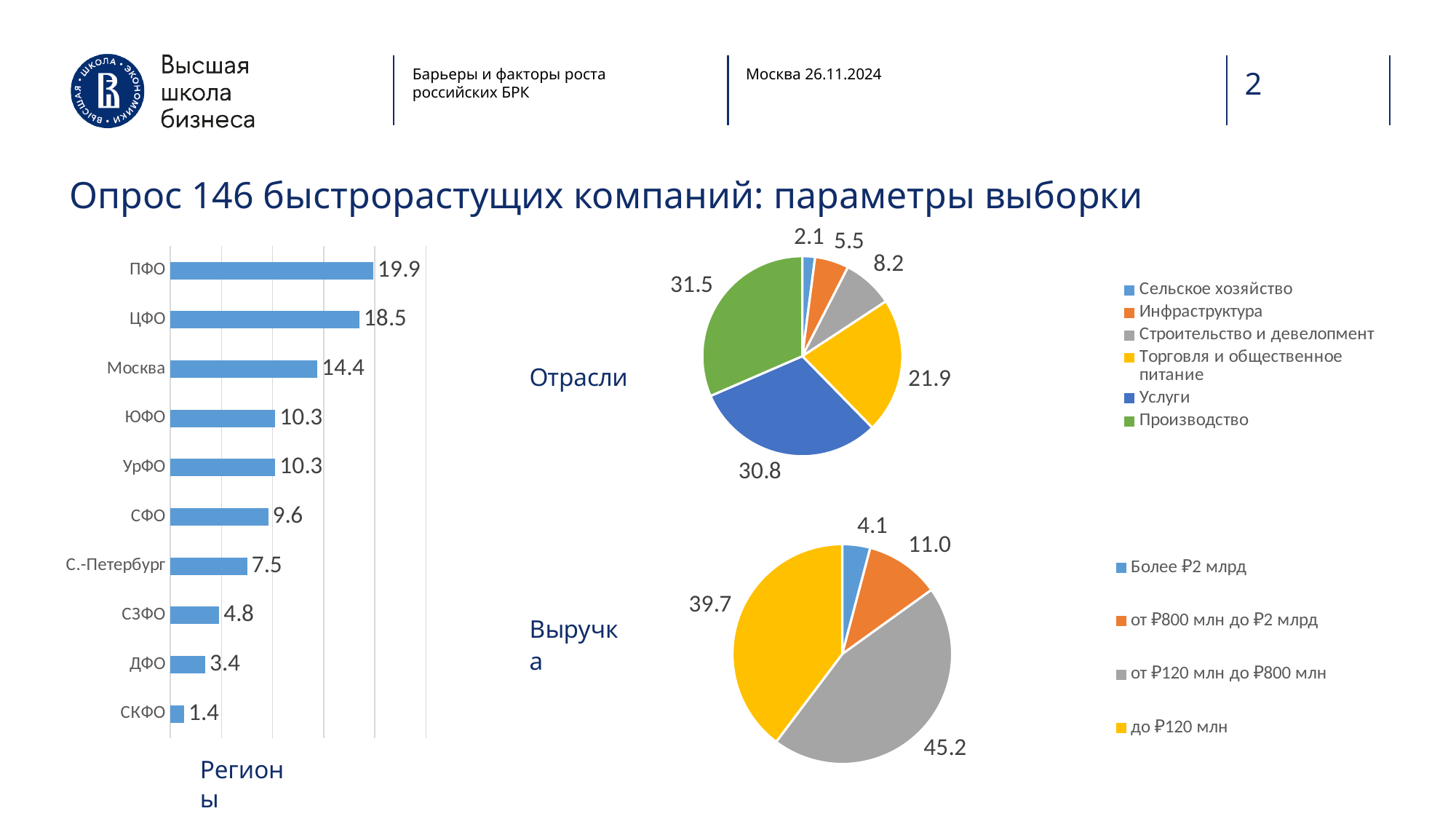
In the 'Регионы' bar chart, which region has the lowest value? СКФО In the 'Регионы' bar chart, which region has the highest value? ПФО In the 'Отрасли' pie chart, which industry has the largest slice? Производство In the 'Отрасли' pie chart, what is the value for Услуги? 30.8 In the 'Выручка' pie chart, which is larger: 'от ₽800 млн до ₽2 млрд' or 'Более ₽2 млрд'? от ₽800 млн до ₽2 млрд In the 'Регионы' bar chart, what is the difference between the values for ПФО and ЦФО? 1.4 In the 'Отрасли' pie chart, how many industries does the legend list? 6 In the 'Выручка' pie chart, what is the value for 'до ₽120 млн'? 39.7 In the 'Регионы' bar chart, what is the value for Москва? 14.4 What type of chart is the 'Регионы' chart? Bar chart In the 'Выручка' pie chart, what is the difference between the values for 'от ₽120 млн до ₽800 млн' and 'до ₽120 млн'? 5.5 In the 'Регионы' bar chart, how many regions are shown? 10